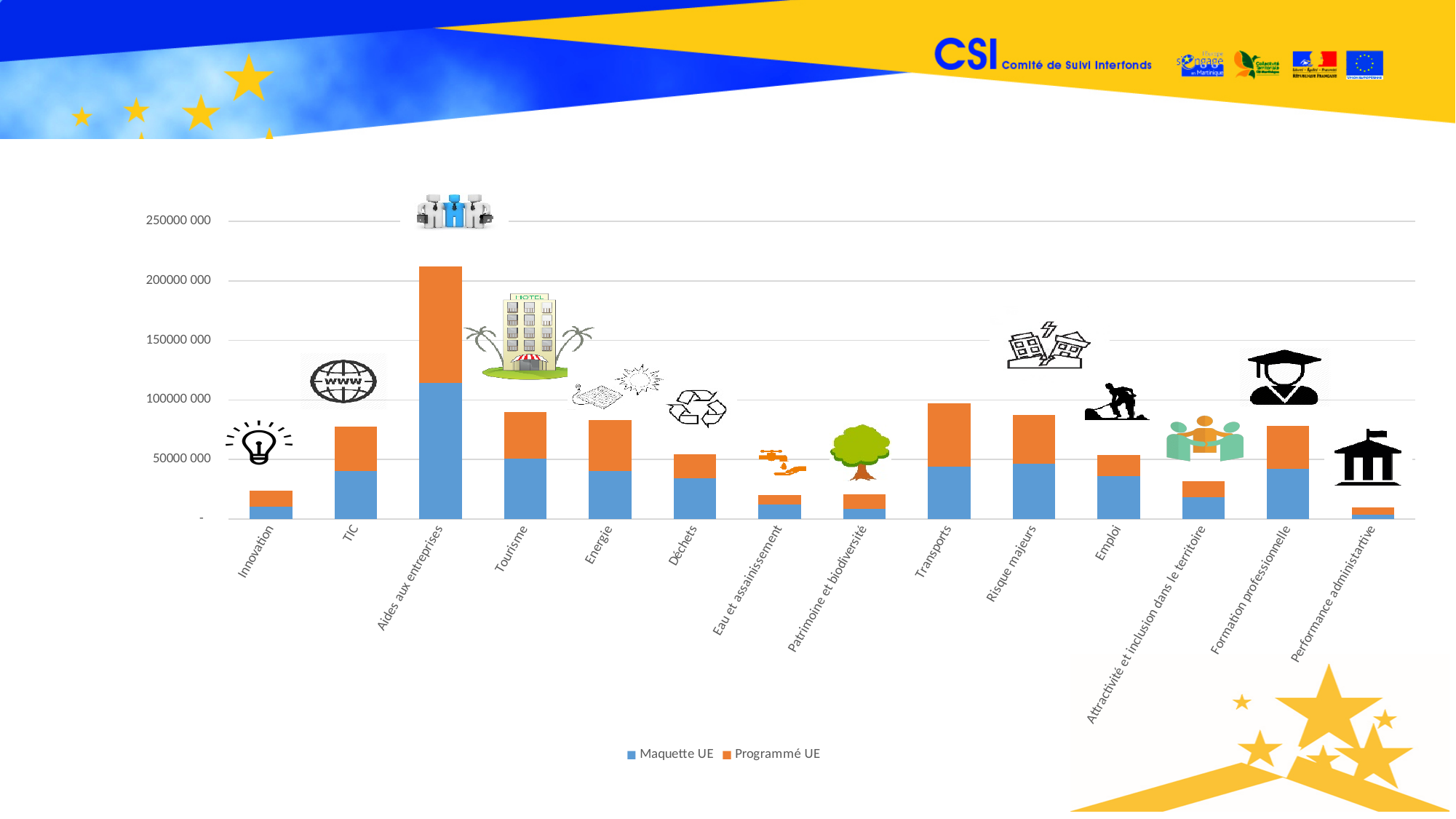
How many series does the chart legend list? 2 Which colour represents the Programmé UE series in the chart? Orange Which category has the highest total bar in the chart? Aides aux entreprises Which category has the lowest total bar in the chart? Performance administartive Is the Maquette UE value for Aides aux entreprises greater or less than 100000 000? greater Is the total bar for TIC greater or less than 50000 000? greater What kind of chart is shown on the slide? Stacked bar chart Is the total bar for Innovation greater or less than 50000 000? less Which has the larger total bar, Transports or Risque majeurs? Transports How many categories are shown along the x axis of the chart? 14 Which two series are listed in the chart legend? Maquette UE and Programmé UE